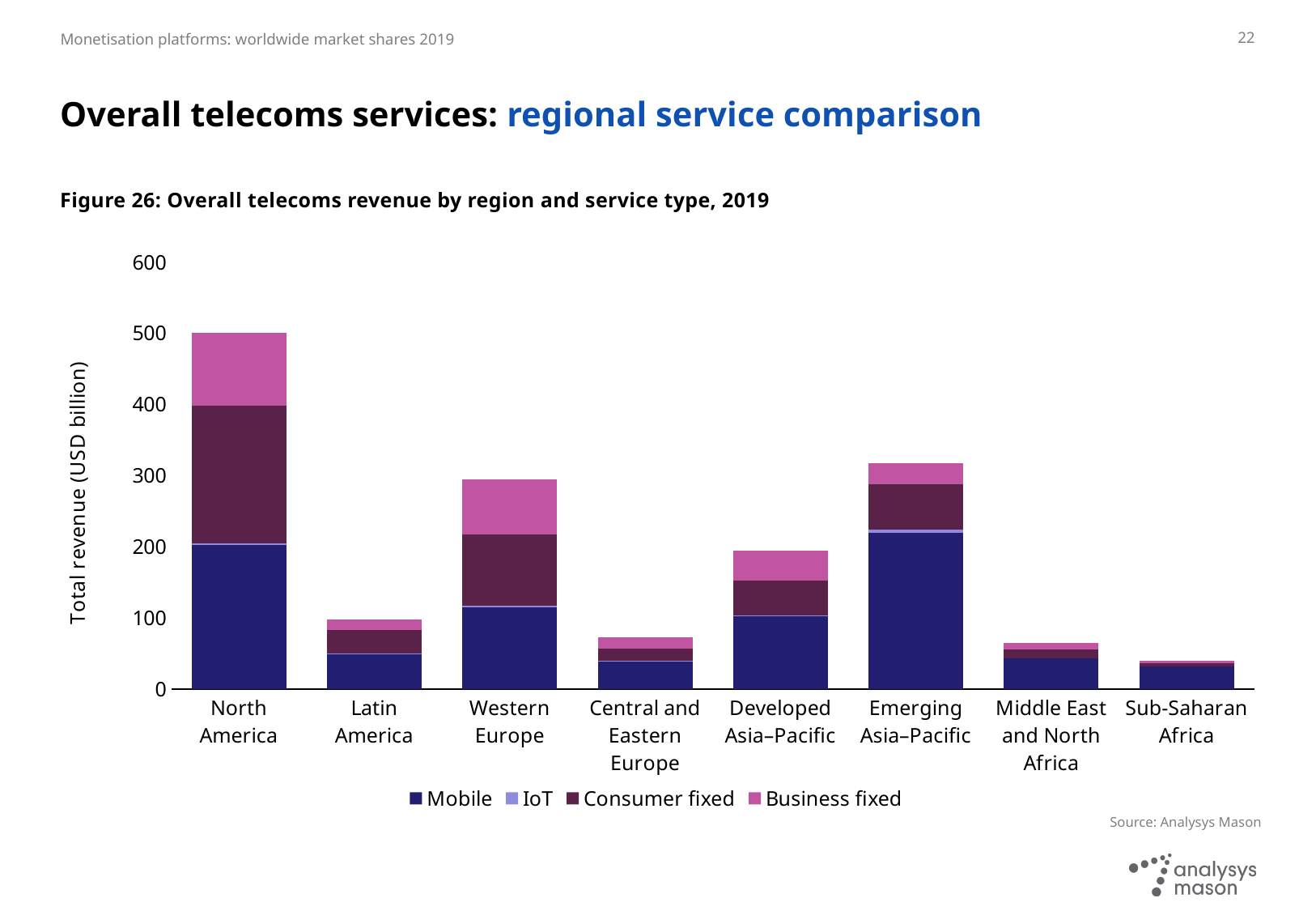
Is the total revenue for North America greater or less than 400? greater How many service types does the legend list? 4 Which has the larger total revenue, North America or Emerging Asia–Pacific? North America Which has the larger total revenue, Developed Asia–Pacific or Latin America? Developed Asia–Pacific What is the label on the y axis of the chart? Total revenue (USD billion) Which region has the lowest total telecoms revenue? Sub-Saharan Africa Is the total revenue for Western Europe greater or less than 200? greater Which region has the highest total telecoms revenue? North America Is the total revenue for Sub-Saharan Africa greater or less than 100? less What kind of chart is shown in Figure 26? Stacked bar chart How many regions are shown on the x axis of the chart? 8